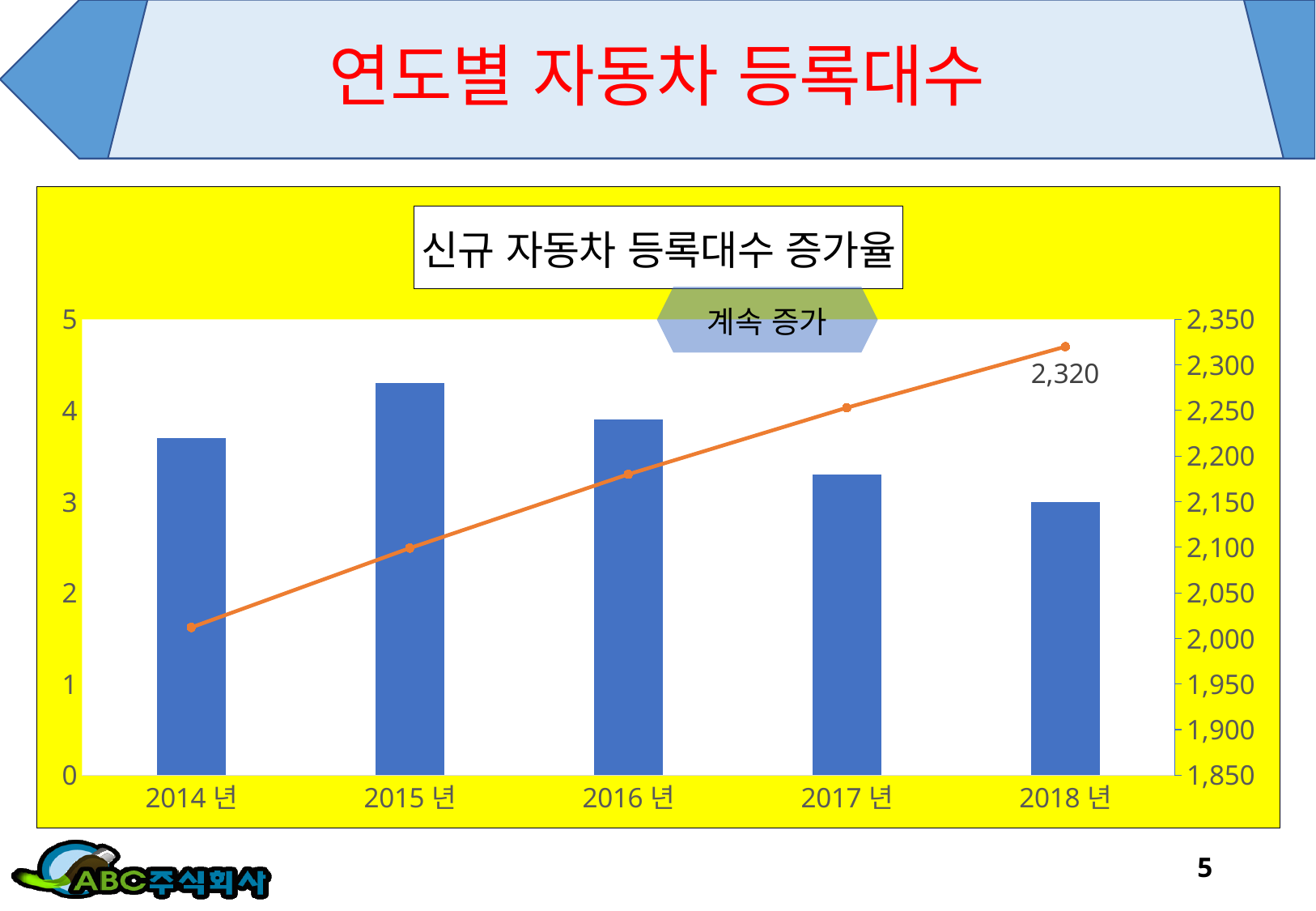
Is the line value for 2014 년 greater or less than 2,050? less Which year has the shortest bar? 2018 년 Is the bar value for 2015 년 greater or less than 4? greater Is the bar value for 2017 년 greater or less than 4? less Do the bars rise or fall from 2015 년 to 2018 년? Fall What is the title of the chart? 신규 자동차 등록대수 증가율 Which year has the tallest bar? 2015 년 Which year has the larger bar, 2014 년 or 2017 년? 2014 년 Does the line series rise or fall from 2014 년 to 2018 년? Rises How many years are shown on the x axis of the chart? 5 What is the value of the line series for 2018 년? 2,320 What kind of chart is shown on the slide? Combination bar and line chart